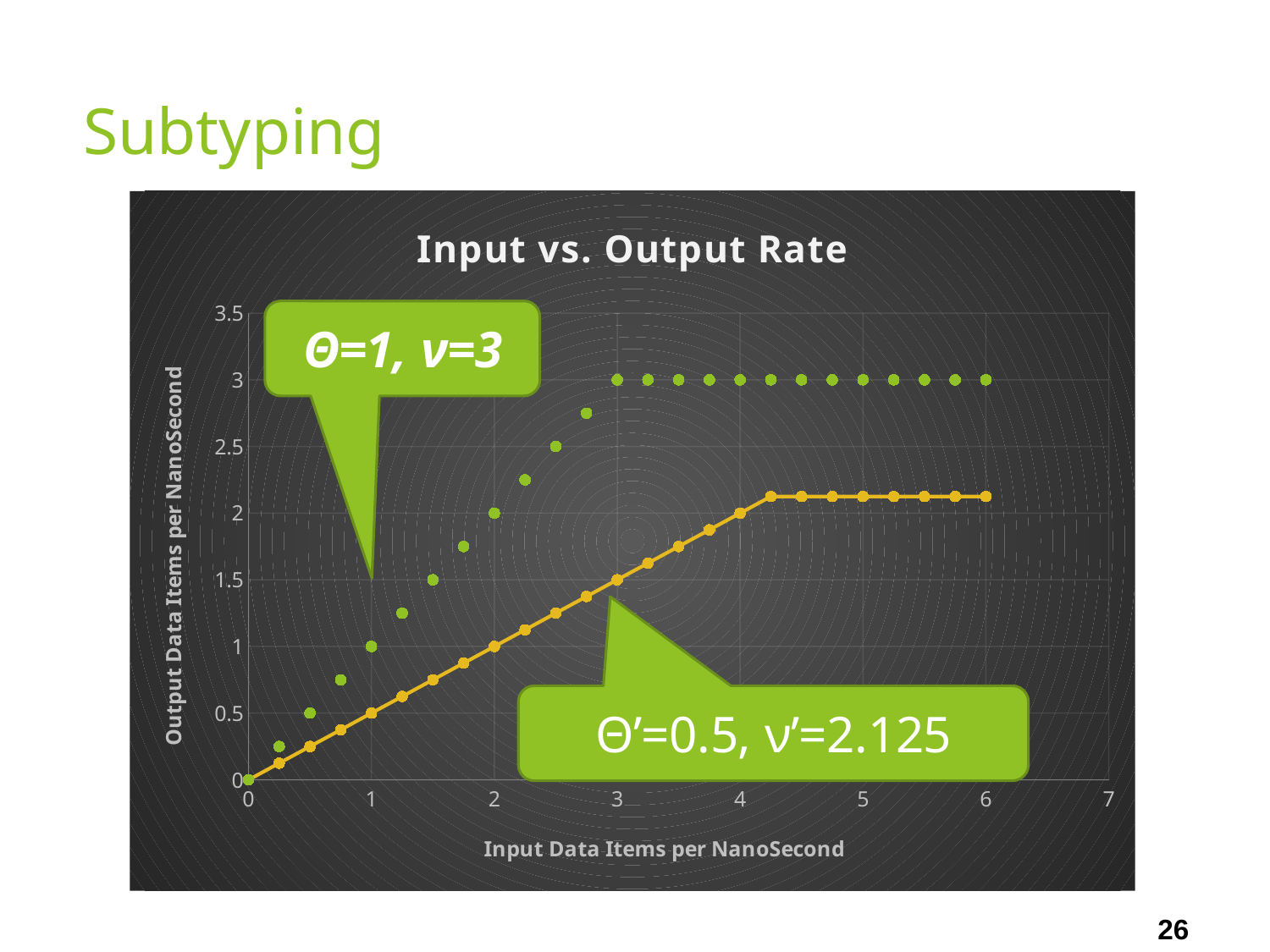
How does the orange (Θ'=0.5, ν'=2.125) series behave as the input rate increases from 0 to 6? rises, then stays flat What is the title of the chart? Input vs. Output Rate What is the label of the x axis? Input Data Items per NanoSecond At an input rate of 2, which series has the higher output rate, the green or the orange? green At an input rate of 3, what is the difference between the green series output rate and the orange series output rate? 1.5 What is the output rate of the orange (Θ'=0.5, ν'=2.125) series at an input rate of 1? 0.5 What is the output rate of the orange (Θ'=0.5, ν'=2.125) series at an input rate of 3? 1.5 How many data series are plotted on the chart? 2 What is the output rate of the green (Θ=1, ν=3) series at an input rate of 1? 1 What kind of chart is shown on the slide? scatter chart Is the plateau value of the orange (Θ'=0.5, ν'=2.125) series greater or less than 2? greater At what output rate does the green (Θ=1, ν=3) series level off? 3